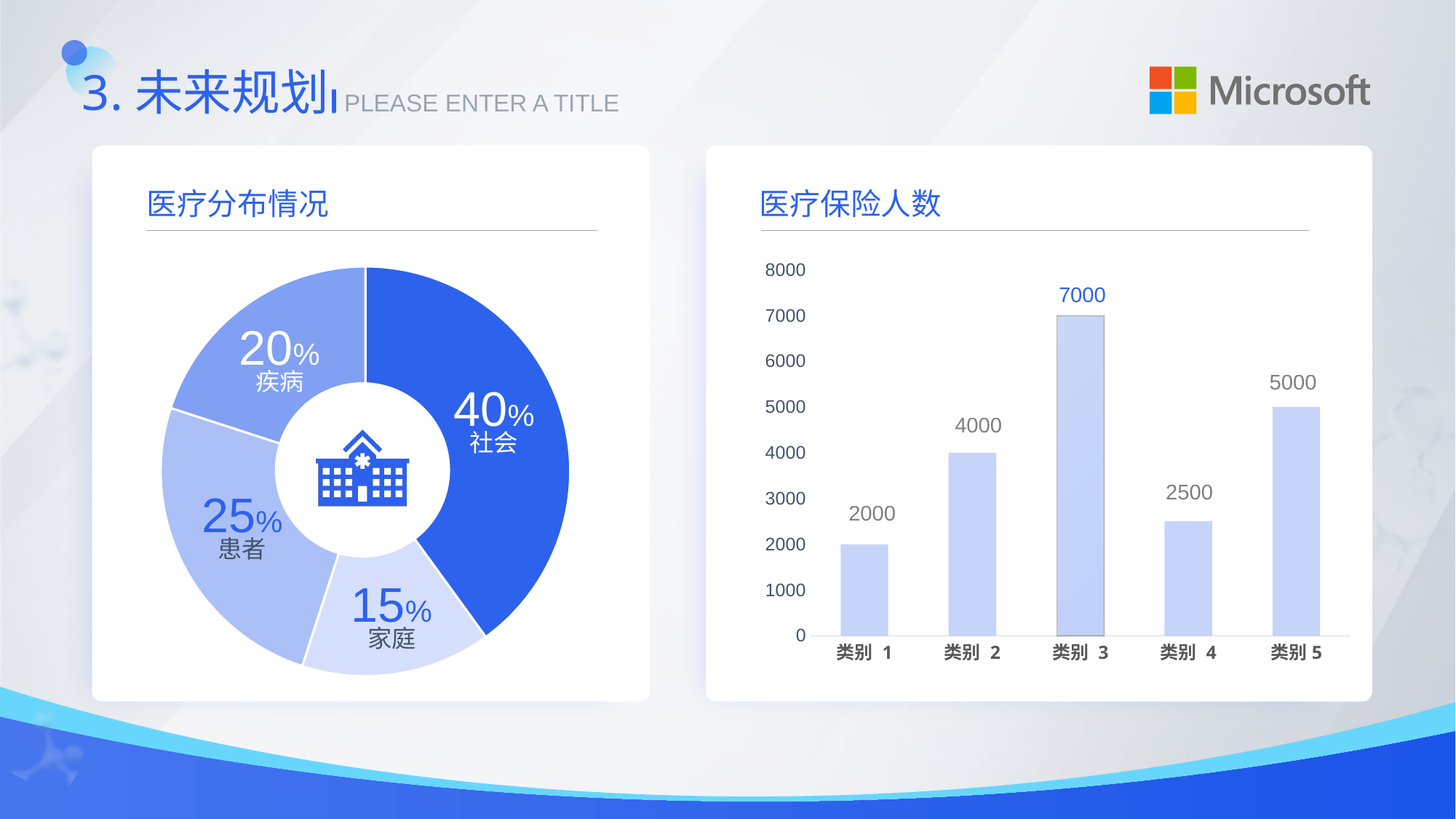
In the 医疗保险人数 chart, what is the difference between 类别 5 and 类别 2? 1000 In the 医疗保险人数 chart, which category has the lowest value? 类别 1 In the 医疗分布情况 chart, which category has the smallest share? 家庭 In the 医疗分布情况 chart, which category has the largest share? 社会 In the 医疗分布情况 chart, how many slices are there? 4 What kind of chart is the 医疗保险人数 chart? bar chart In the 医疗保险人数 chart, which is larger, 类别 2 or 类别 4? 类别 2 In the 医疗分布情况 chart, what share does 社会 have? 40% In the 医疗分布情况 chart, what share does 家庭 have? 15% In the 医疗保险人数 chart, what is the value for 类别 4? 2500 In the 医疗保险人数 chart, what is the value for 类别 3? 7000 What kind of chart is the 医疗分布情况 chart? pie chart